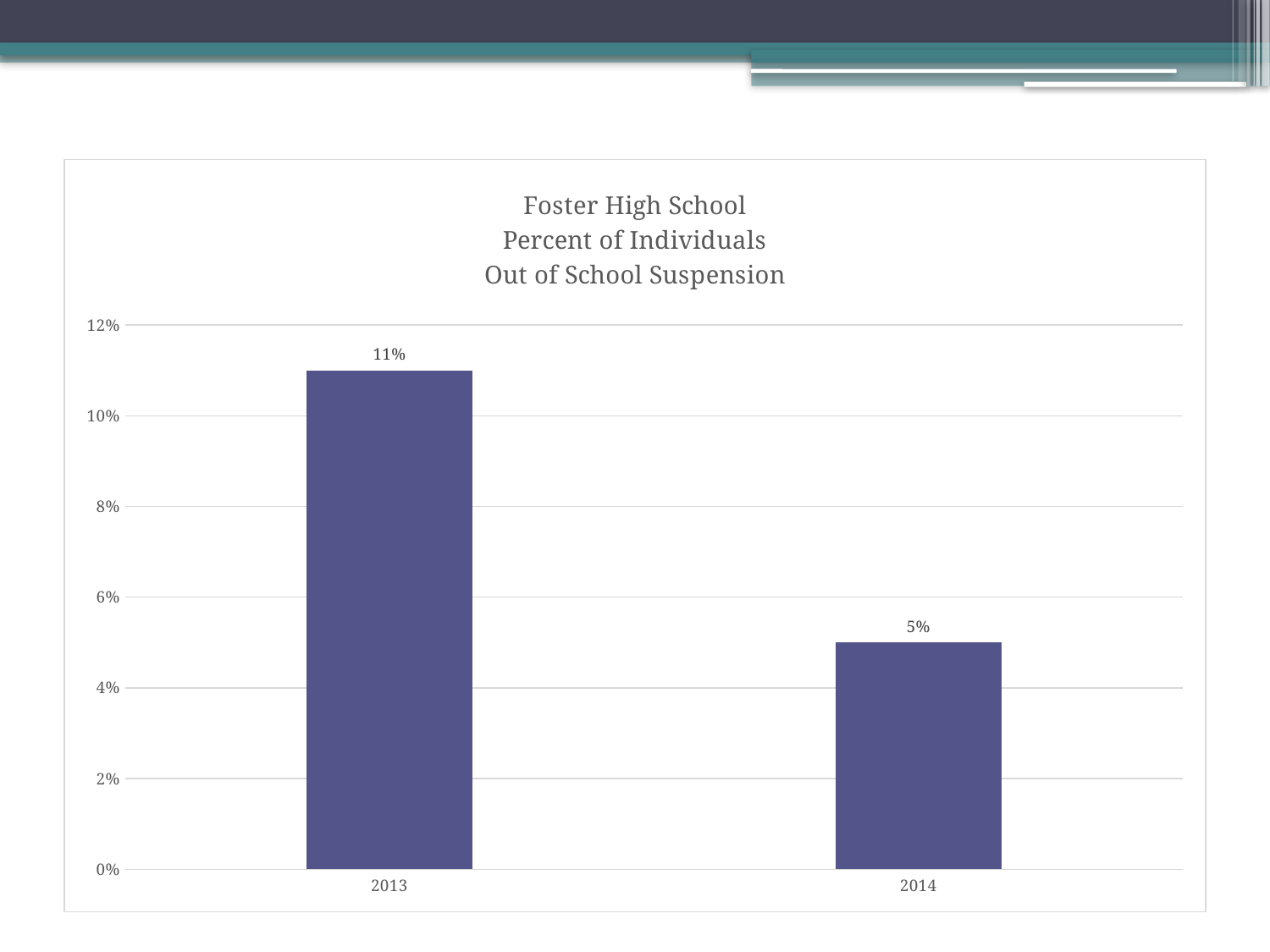
Is the value for 2013 greater or less than 10%? greater What is the value for 2013? 11% Which year has the highest percent of individuals with out of school suspension? 2013 Which is larger, the value for 2013 or the value for 2014? 2013 Which year has the lowest percent of individuals with out of school suspension? 2014 What is the title of the chart? Foster High School Percent of Individuals Out of School Suspension What kind of chart is shown on the slide? bar chart What is the difference between the values for 2013 and 2014? 6% What is the value for 2014? 5% How many years are shown on the x axis? 2 Is the value for 2014 greater or less than 6%? less Do the values rise or fall from 2013 to 2014? fall